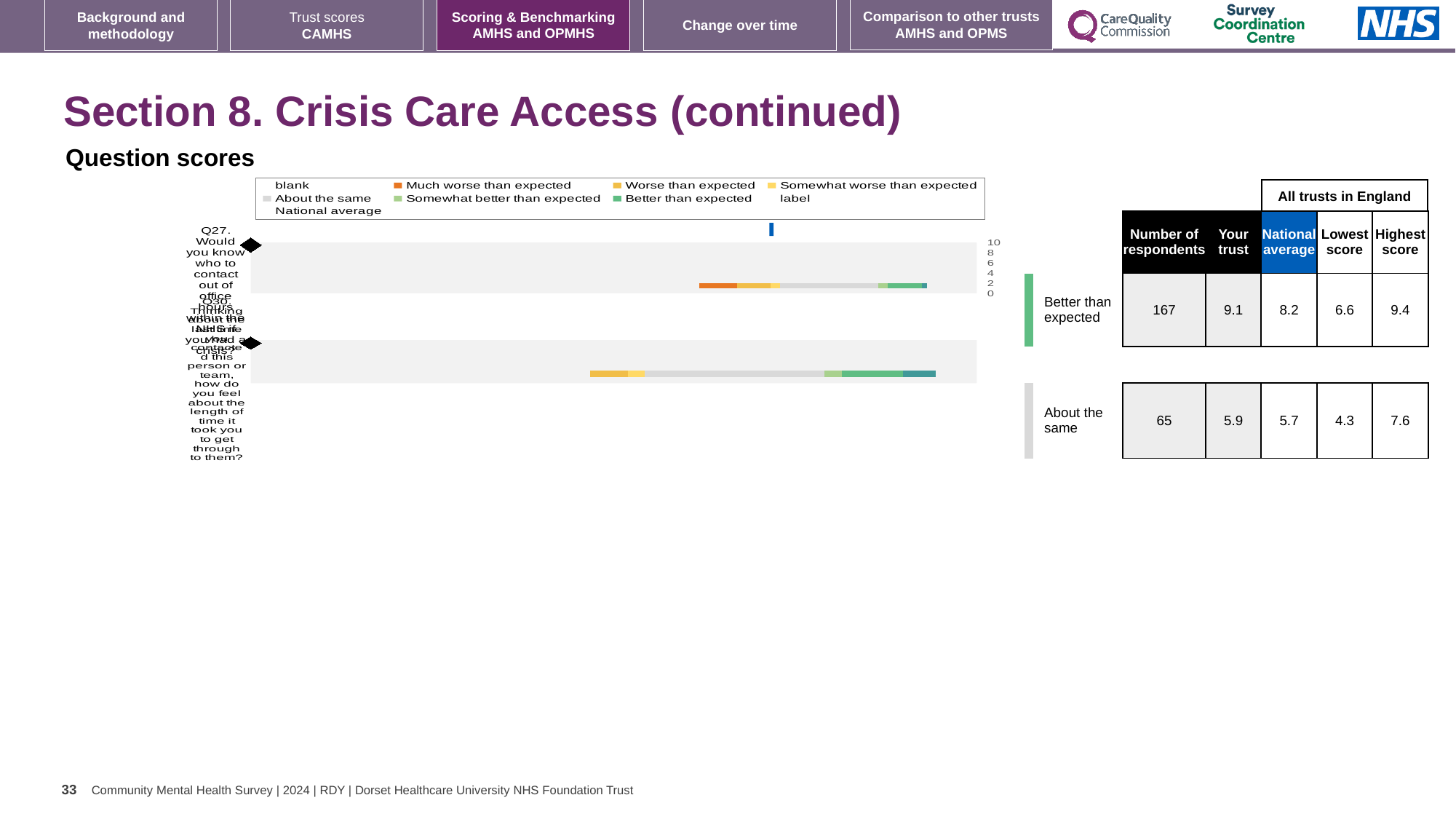
How many questions (categories) are plotted in the question scores chart? 2 What benchmark category is shown next to the chart for Q27? Better than expected In the table beside the chart, what is the number of respondents for Q27 (Would you know who to contact out of office hours)? 167 By how much does the 'Your trust' score for Q27 (9.1) exceed the national average (8.2)? 0.9 In the table beside the chart, what is the 'Your trust' score for Q27? 9.1 Which legend entry in the chart is shown in orange? Much worse than expected What kind of chart is used to show the question scores on this slide? bar chart In the table beside the chart, what is the national average for Q30 (how do you feel about the length of time it took you to get through)? 5.7 In the table beside the chart, what is the lowest score across all trusts in England for Q30? 4.3 In the table beside the chart, what is the highest score across all trusts in England for Q27? 9.4 For Q30, which is larger: the 'Your trust' score or the national average? Your trust What is the highest tick value shown on the chart's score axis? 10